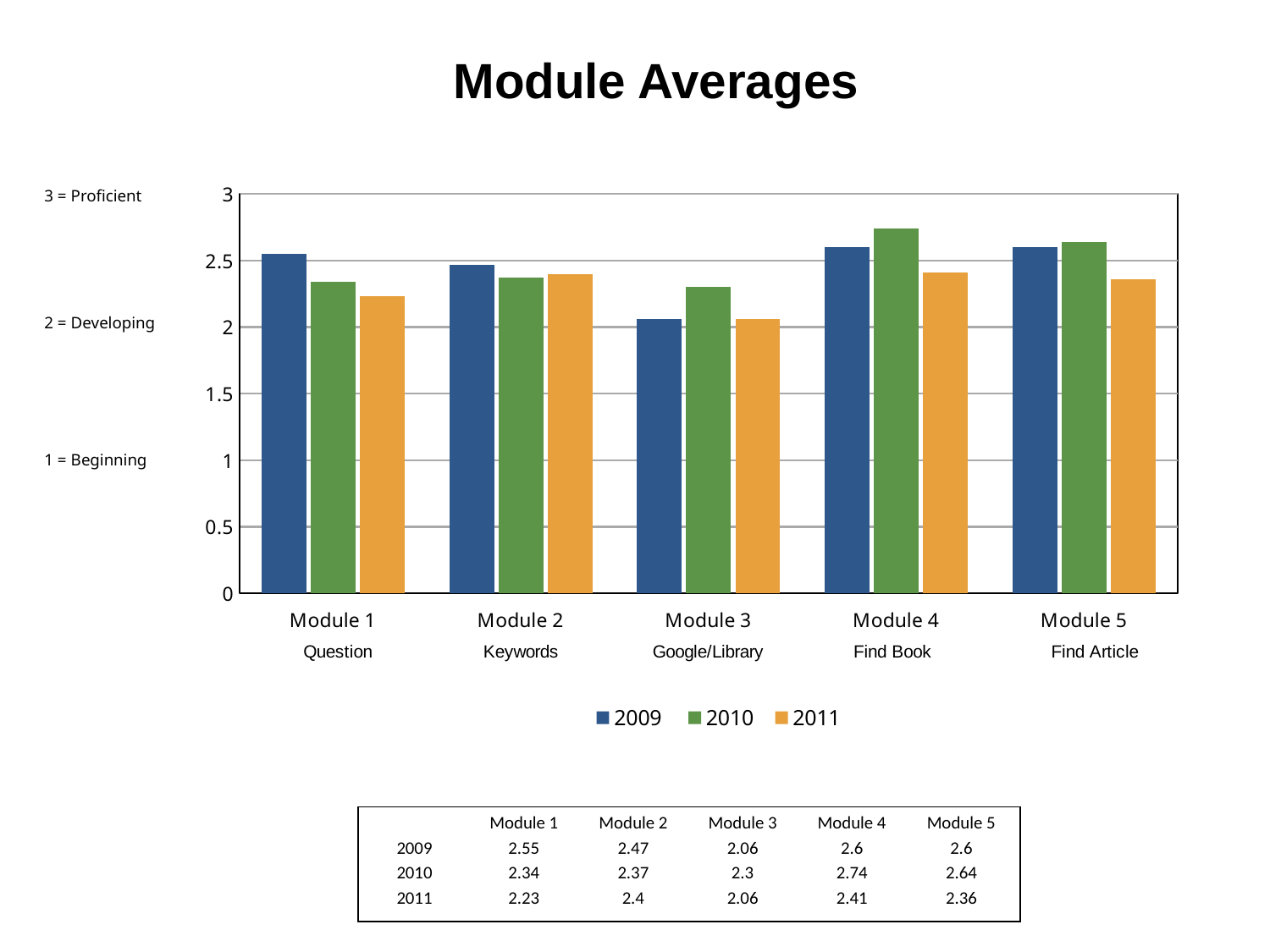
Which is larger for Module 2: the 2009 value or the 2011 value? 2009 What is the 2011 value for Module 4? 2.41 What is the 2009 value for Module 1? 2.55 Which module has the lowest 2009 value? Module 3 What kind of chart is shown? bar chart What is the difference between the 2010 and 2011 values for Module 4? 0.33 Is the 2011 value for Module 3 greater or less than 2.5? less How many modules are shown on the x axis? 5 Which module has the highest 2010 value? Module 4 What is the title of the chart? Module Averages How many series does the legend list? 3 What is the 2010 value for Module 3? 2.3